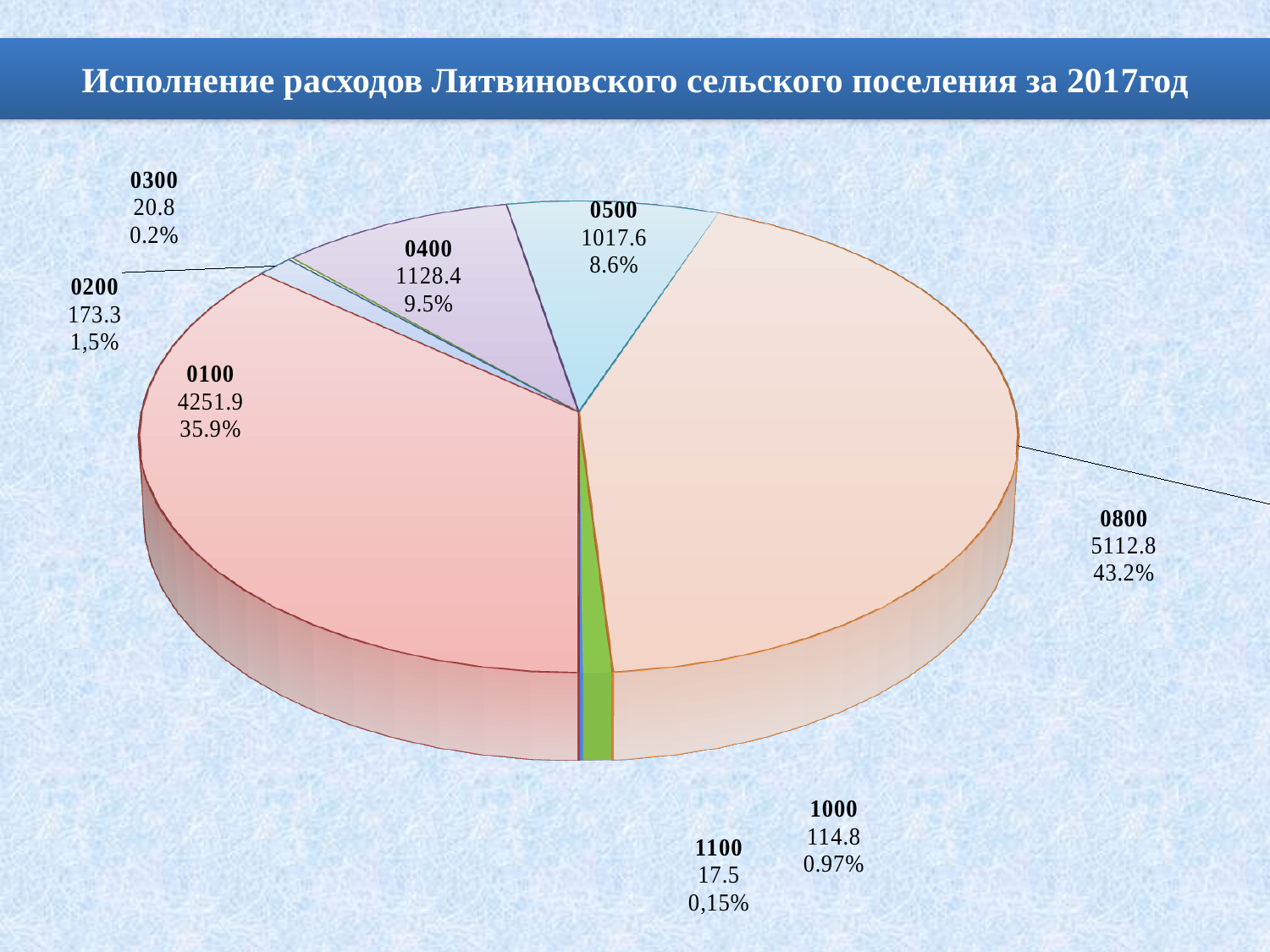
Which category has the smallest slice of the pie? 1100 What share of the pie does category 0400 represent? 9.5% What is the title of the slide? Исполнение расходов Литвиновского сельского поселения за 2017год How many categories are shown in the pie chart? 8 What is the difference between the values for 0800 and 0100? 860.9 What is the value for category 0200? 173.3 What is the value for category 0100? 4251.9 Which is larger, the value for 0400 or the value for 0500? 0400 Which category has the largest slice of the pie? 0800 What kind of chart is shown on the slide? pie chart What share of the pie does category 0500 represent? 8.6% What is the value for category 0800? 5112.8